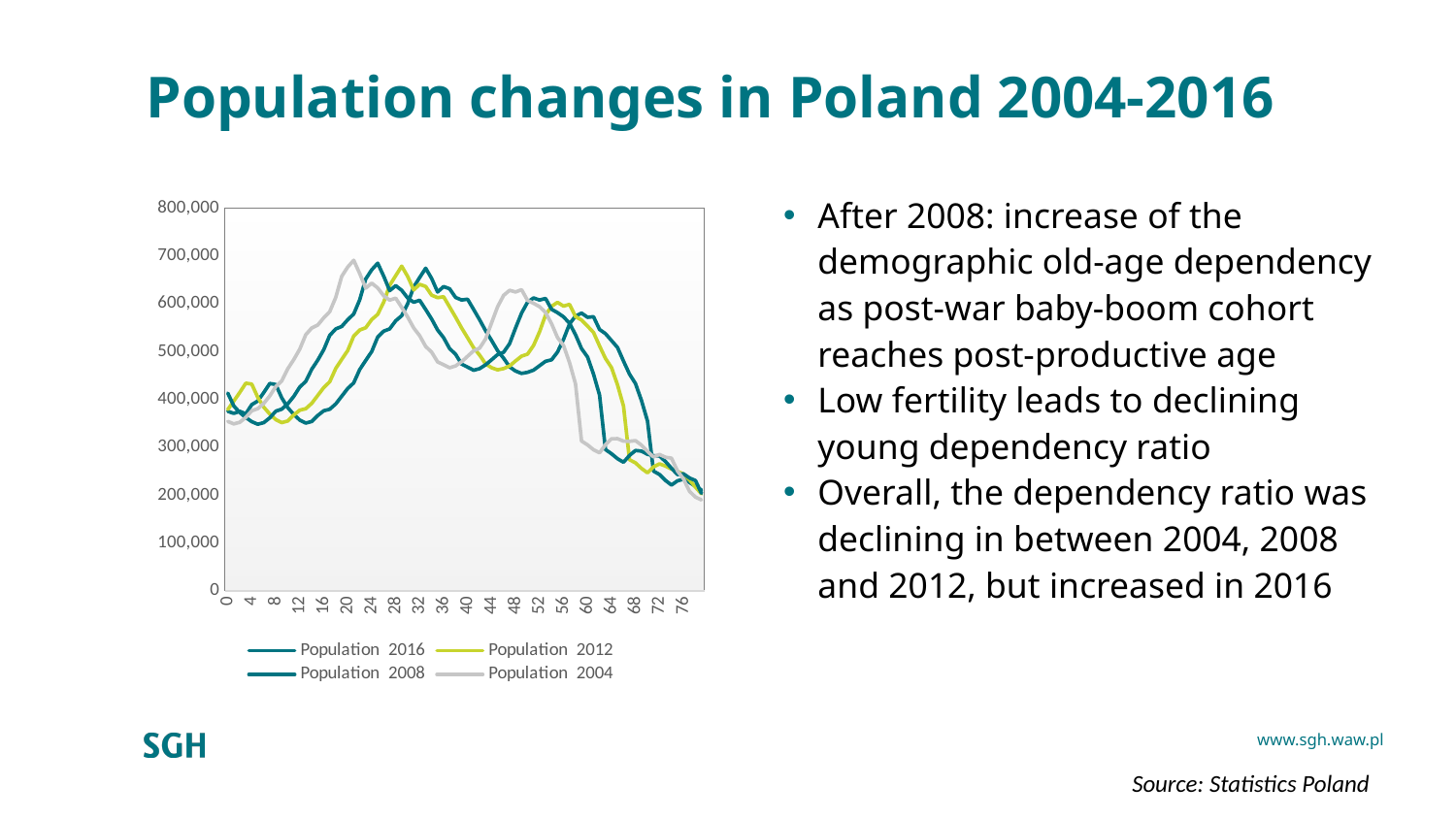
What kind of chart is shown on the slide? line chart How many series does the chart legend list? 4 Which series has the highest value at age 20? Population 2004 Which series is shown in grey in the chart legend? Population 2004 Is the value for Population 2016 at age 76 greater or less than 300,000? less Is the value for Population 2004 at age 20 greater or less than 600,000? greater Is the value for Population 2004 at age 60 greater or less than 400,000? less Which series has the lowest value at age 20? Population 2016 What is the highest value labelled on the vertical axis of the chart? 800,000 Do the values for Population 2004 rise or fall between age 60 and age 76? fall